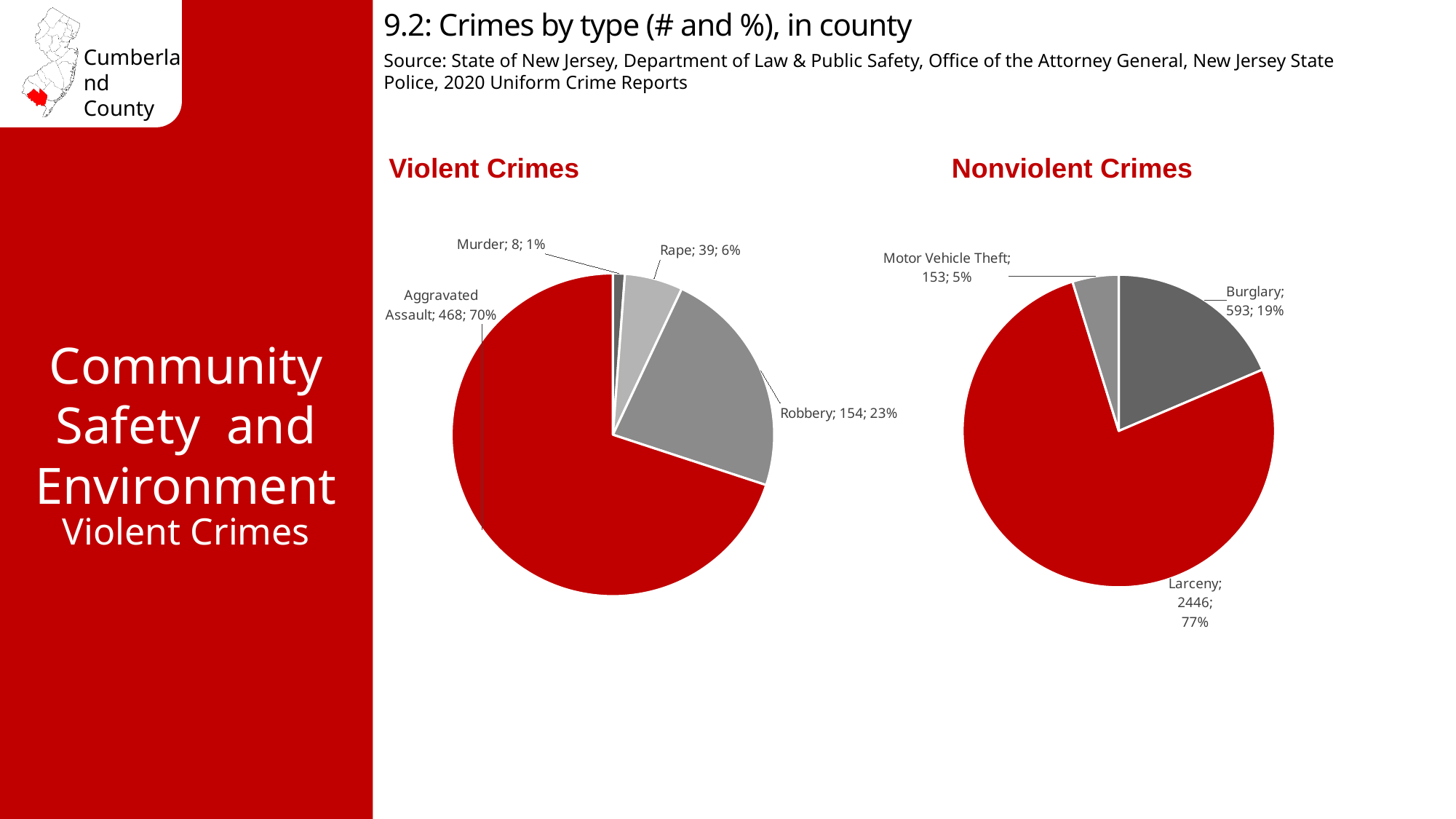
What kind of chart is the Violent Crimes chart? Pie chart In the Violent Crimes chart, how many categories are shown? 4 In the Violent Crimes chart, what is the difference between the number of robberies and the number of rapes? 115 In the Nonviolent Crimes chart, which is larger, Burglary or Motor Vehicle Theft? Burglary In the Violent Crimes chart, which category has the largest slice? Aggravated Assault In the Nonviolent Crimes chart, how many larcenies are shown? 2446 In the Violent Crimes chart, how many aggravated assaults are shown? 468 In the Violent Crimes chart, which category has the smallest slice? Murder In the Violent Crimes chart, what share of the pie is Robbery? 23% In the Nonviolent Crimes chart, which category has the smallest slice? Motor Vehicle Theft In the Nonviolent Crimes chart, what share of the pie is Burglary? 19% In the Nonviolent Crimes chart, what is the difference between the number of burglaries and the number of motor vehicle thefts? 440